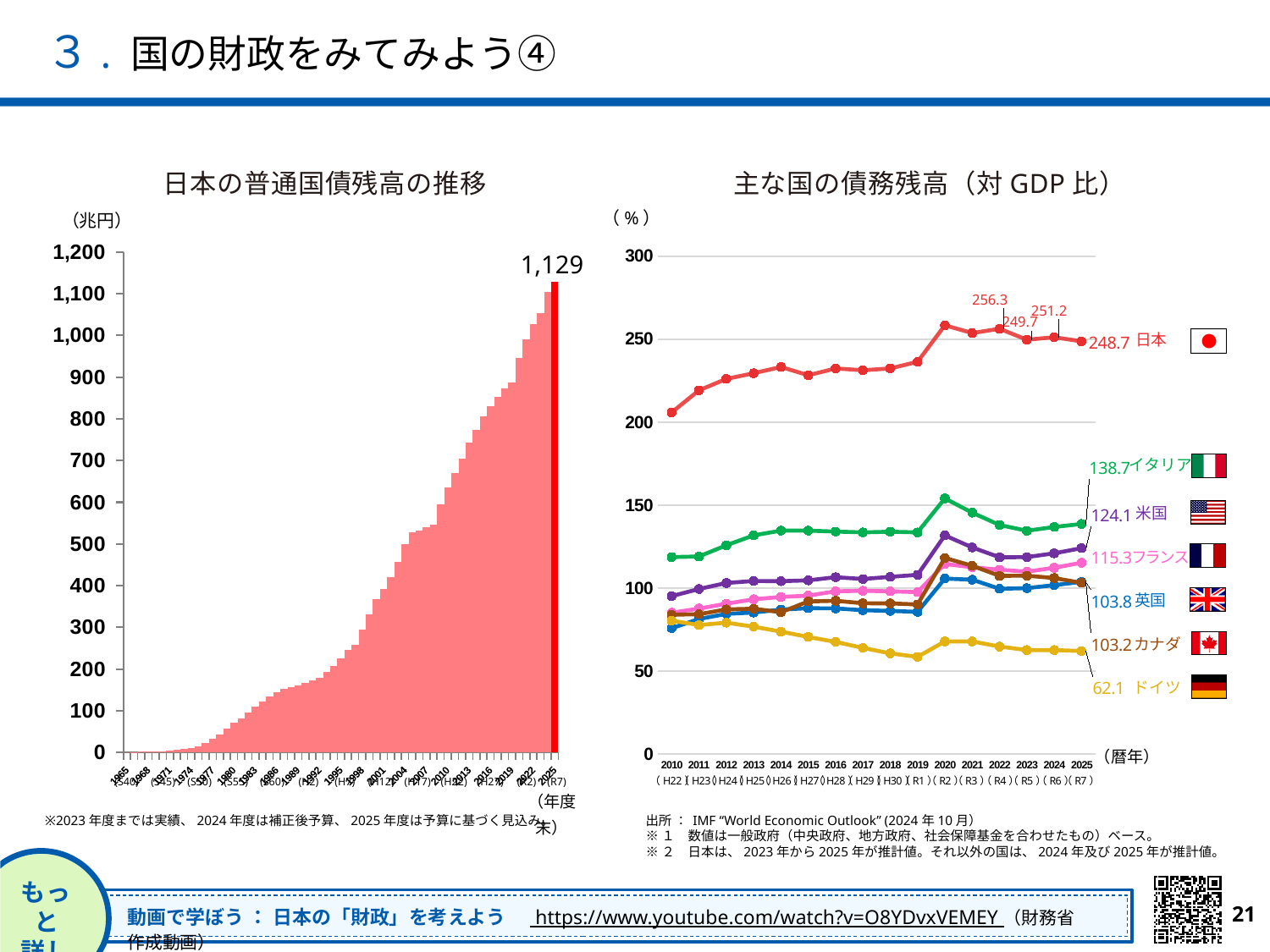
In the right chart 主な国の債務残高（対GDP比）, what is the value for ドイツ in 2025? 62.1 In the right chart 主な国の債務残高（対GDP比）, which is larger in 2025, 米国 or フランス? 米国 In the left chart 日本の普通国債残高の推移, do the values generally rise or fall from 1965 to 2025? rise In the right chart 主な国の債務残高（対GDP比）, which country has the lowest value in 2025? ドイツ In the left chart 日本の普通国債残高の推移, what unit is shown on the y axis? 兆円 In the right chart 主な国の債務残高（対GDP比）, what is the difference between 日本 (248.7) and イタリア (138.7) in 2025? 110.0 In the left chart 日本の普通国債残高の推移, what is the value shown for 2025? 1,129 What kind of chart is the right chart titled 主な国の債務残高（対GDP比）? line chart What kind of chart is the left chart titled 日本の普通国債残高の推移? bar chart In the right chart 主な国の債務残高（対GDP比）, how many countries are plotted? 7 In the right chart 主な国の債務残高（対GDP比）, which country has the highest value in 2025? 日本 In the right chart 主な国の債務残高（対GDP比）, what is the value for 日本 in 2025? 248.7